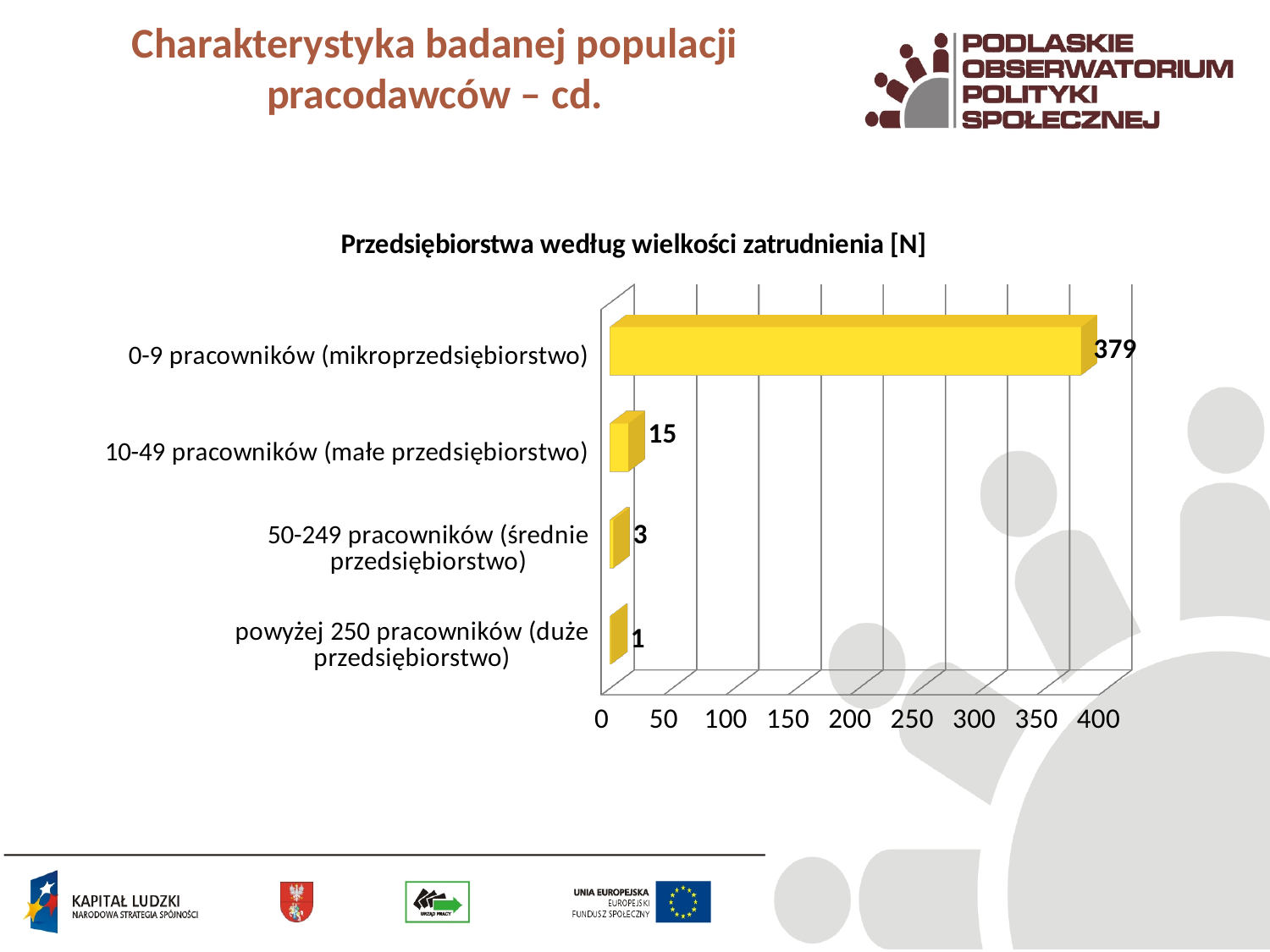
Which category has the highest value? 0-9 pracowników (mikroprzedsiębiorstwo) Which is larger: the value for 10-49 pracowników (małe przedsiębiorstwo) or for 50-249 pracowników (średnie przedsiębiorstwo)? 10-49 pracowników (małe przedsiębiorstwo) What is the value for powyżej 250 pracowników (duże przedsiębiorstwo)? 1 What kind of chart is shown on the slide? bar chart What is the difference between the values for 0-9 pracowników (mikroprzedsiębiorstwo) and 10-49 pracowników (małe przedsiębiorstwo)? 364 What is the value for 0-9 pracowników (mikroprzedsiębiorstwo)? 379 What is the title of the chart? Przedsiębiorstwa według wielkości zatrudnienia [N] How many categories are shown in the chart? 4 Is the value for 0-9 pracowników (mikroprzedsiębiorstwo) greater or less than 350? greater What is the value for 10-49 pracowników (małe przedsiębiorstwo)? 15 Which category has the lowest value? powyżej 250 pracowników (duże przedsiębiorstwo) What is the value for 50-249 pracowników (średnie przedsiębiorstwo)? 3